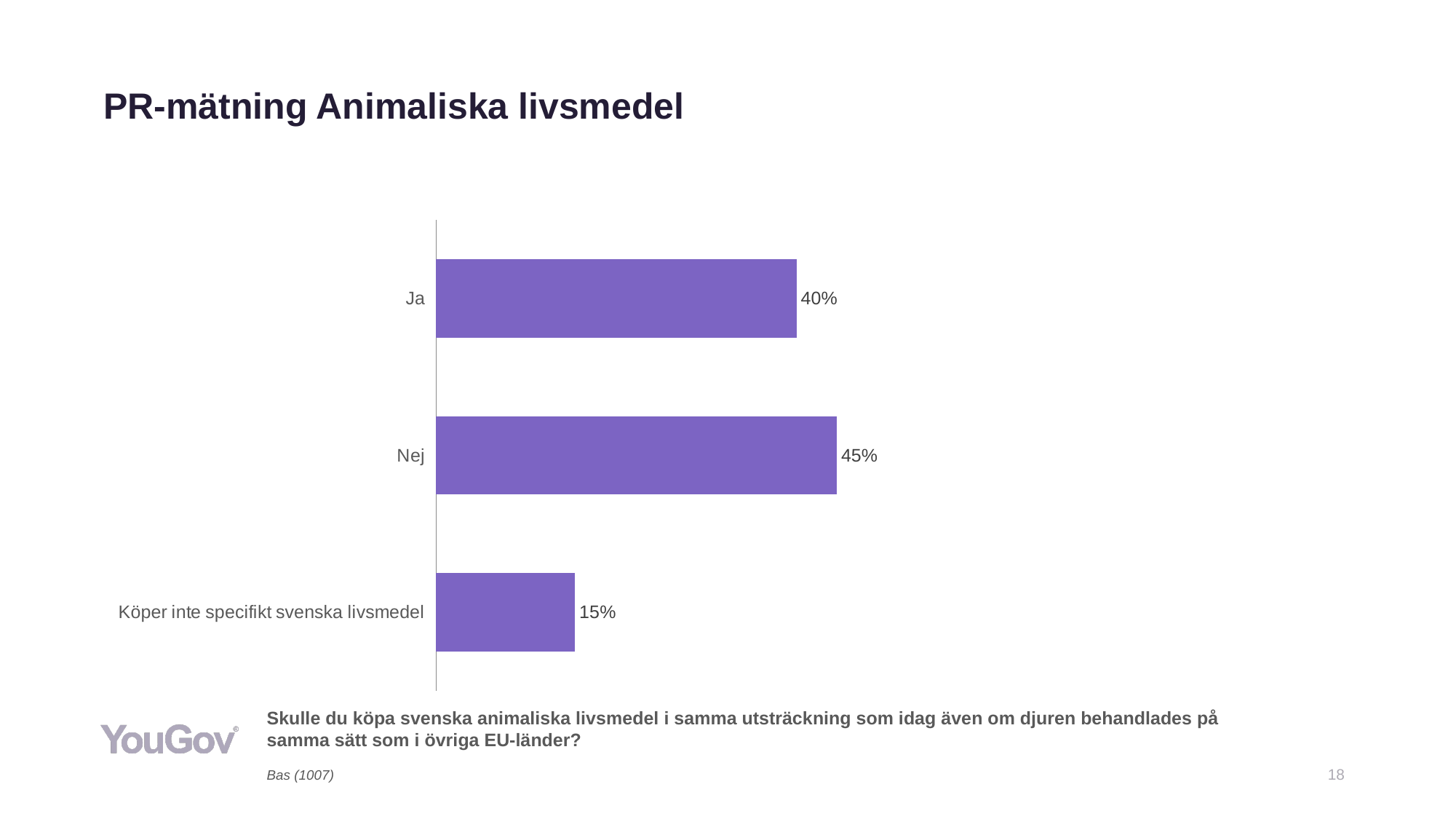
What is the base (Bas) size shown below the chart? 1007 Which category has the lowest value? Köper inte specifikt svenska livsmedel What is the value for "Nej"? 45% What is the difference between the values for "Nej" and "Ja"? 5% What is the difference between the values for "Ja" and "Köper inte specifikt svenska livsmedel"? 25% How many categories are shown in the chart? 3 Which is larger, the value for "Ja" or the value for "Nej"? Nej What is the title of the slide? PR-mätning Animaliska livsmedel What is the value for "Köper inte specifikt svenska livsmedel"? 15% What is the value for "Ja"? 40% What kind of chart is shown on the slide? Bar chart Which category has the highest value? Nej